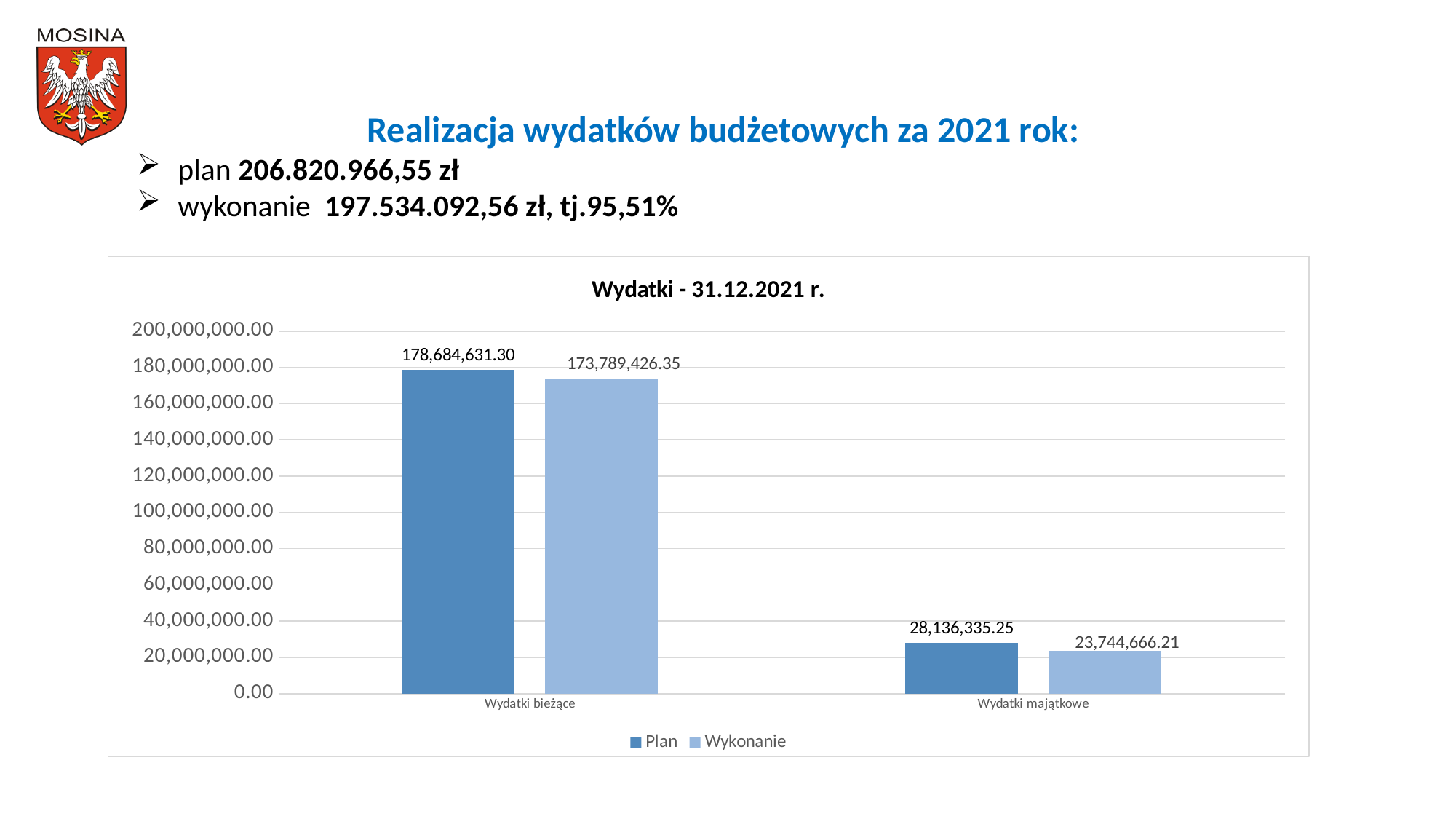
What is the Plan value for Wydatki bieżące? 178,684,631.30 What is the difference between the Plan and Wykonanie values for Wydatki bieżące? 4,895,204.95 What is the Wykonanie value for Wydatki bieżące? 173,789,426.35 What is the difference between the Plan and Wykonanie values for Wydatki majątkowe? 4,391,669.04 What is the Wykonanie value for Wydatki majątkowe? 23,744,666.21 Which category has the lowest Wykonanie value? Wydatki majątkowe Which category has the highest Plan value? Wydatki bieżące What is the Plan value for Wydatki majątkowe? 28,136,335.25 What is the title of the chart? Wydatki - 31.12.2021 r. Is the Wykonanie value for Wydatki bieżące greater or less than 160,000,000.00? greater For Wydatki majątkowe, which is larger: Plan or Wykonanie? Plan How many series does the legend list? 2